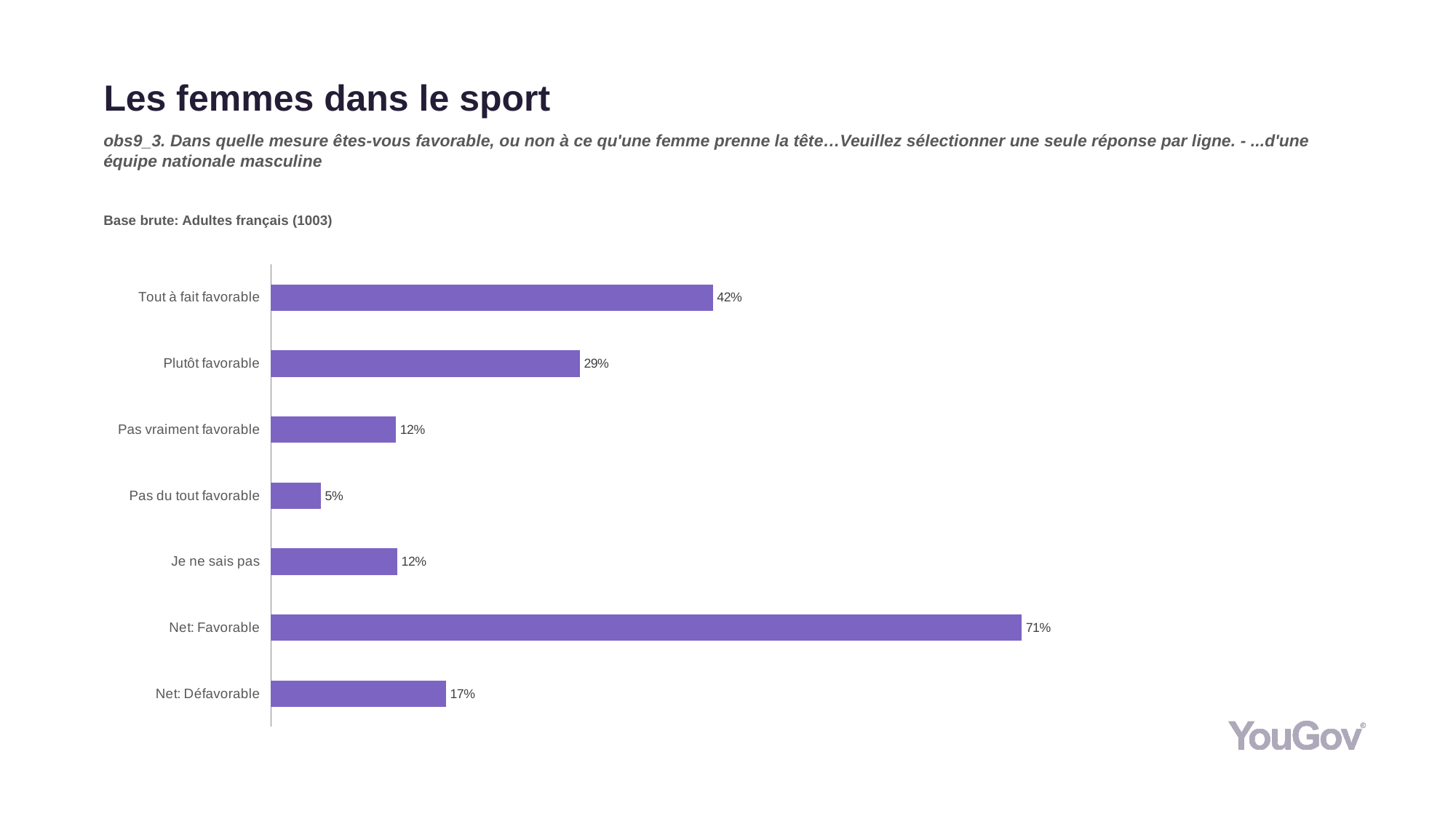
What is the difference between "Net: Favorable" and "Net: Défavorable"? 54 percentage points How many categories are shown in the chart? 7 What is the value for "Plutôt favorable"? 29% Which is larger, "Pas vraiment favorable" or "Pas du tout favorable"? Pas vraiment favorable What is the value for "Net: Défavorable"? 17% What kind of chart is shown on the slide? Bar chart What is the value for "Tout à fait favorable"? 42% What is the base (sample) stated on the slide? Adultes français (1003) What is the value for "Pas du tout favorable"? 5% Which category has the highest value? Net: Favorable Which category has the lowest value? Pas du tout favorable What is the difference between "Tout à fait favorable" and "Plutôt favorable"? 13 percentage points